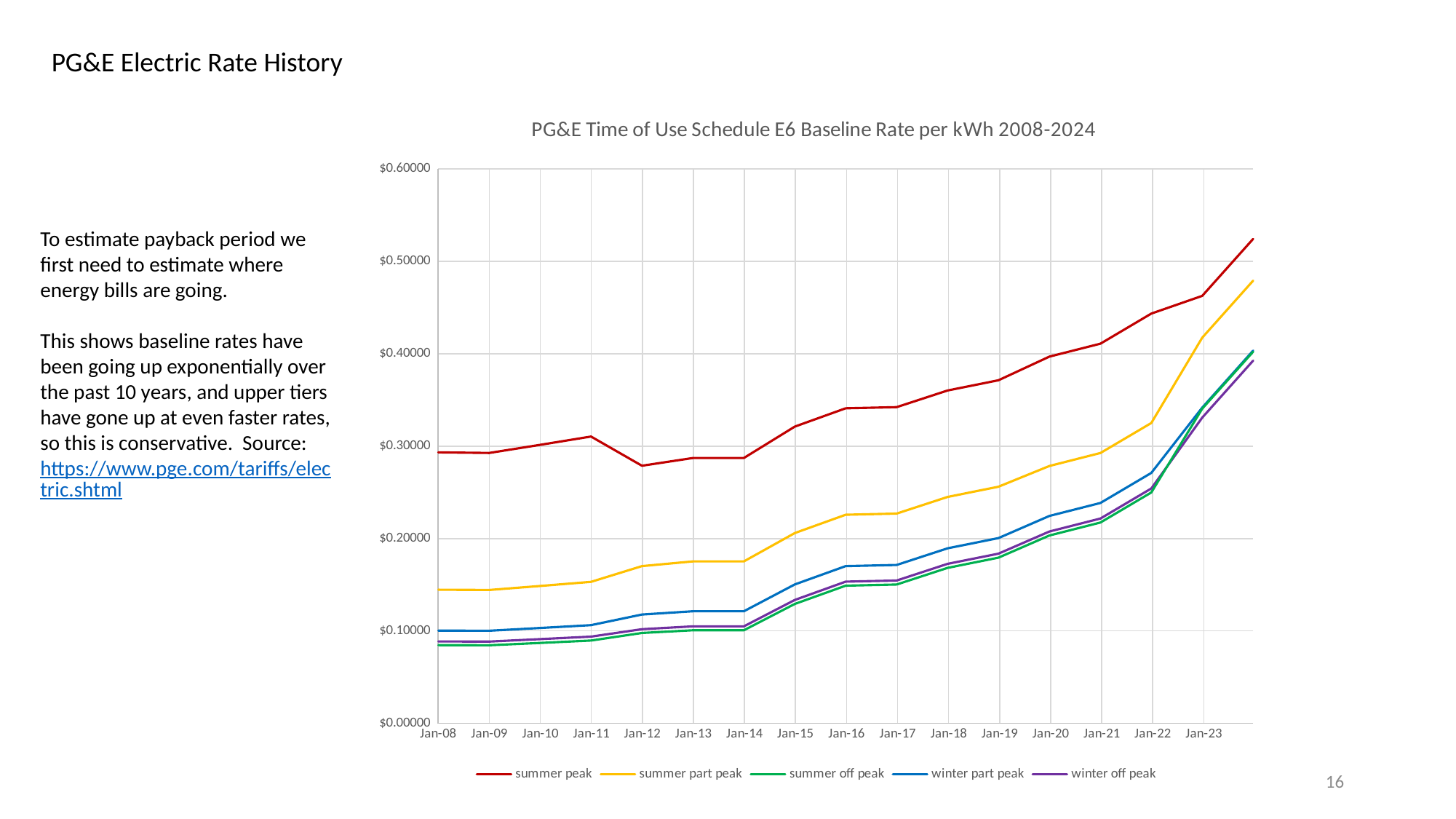
Does the summer part peak series generally rise or fall from Jan-08 to the end of the chart? rise Is the value for summer peak at Jan-16 greater or less than $0.30000? greater At which x-axis label does the summer peak series reach its lowest value? Jan-12 How many year labels are shown on the x axis? 16 Is the value for summer part peak at Jan-14 greater or less than $0.20000? less What is the title of the chart? PG&E Time of Use Schedule E6 Baseline Rate per kWh 2008-2024 Does the summer peak series rise or fall between Jan-11 and Jan-12? fall What kind of chart is shown on the slide? line chart Is the value for summer peak at Jan-22 greater or less than $0.40000? greater Which series has the highest values across the whole chart? summer peak At Jan-16, which is larger: winter part peak or summer off peak? winter part peak How many series does the legend list? 5